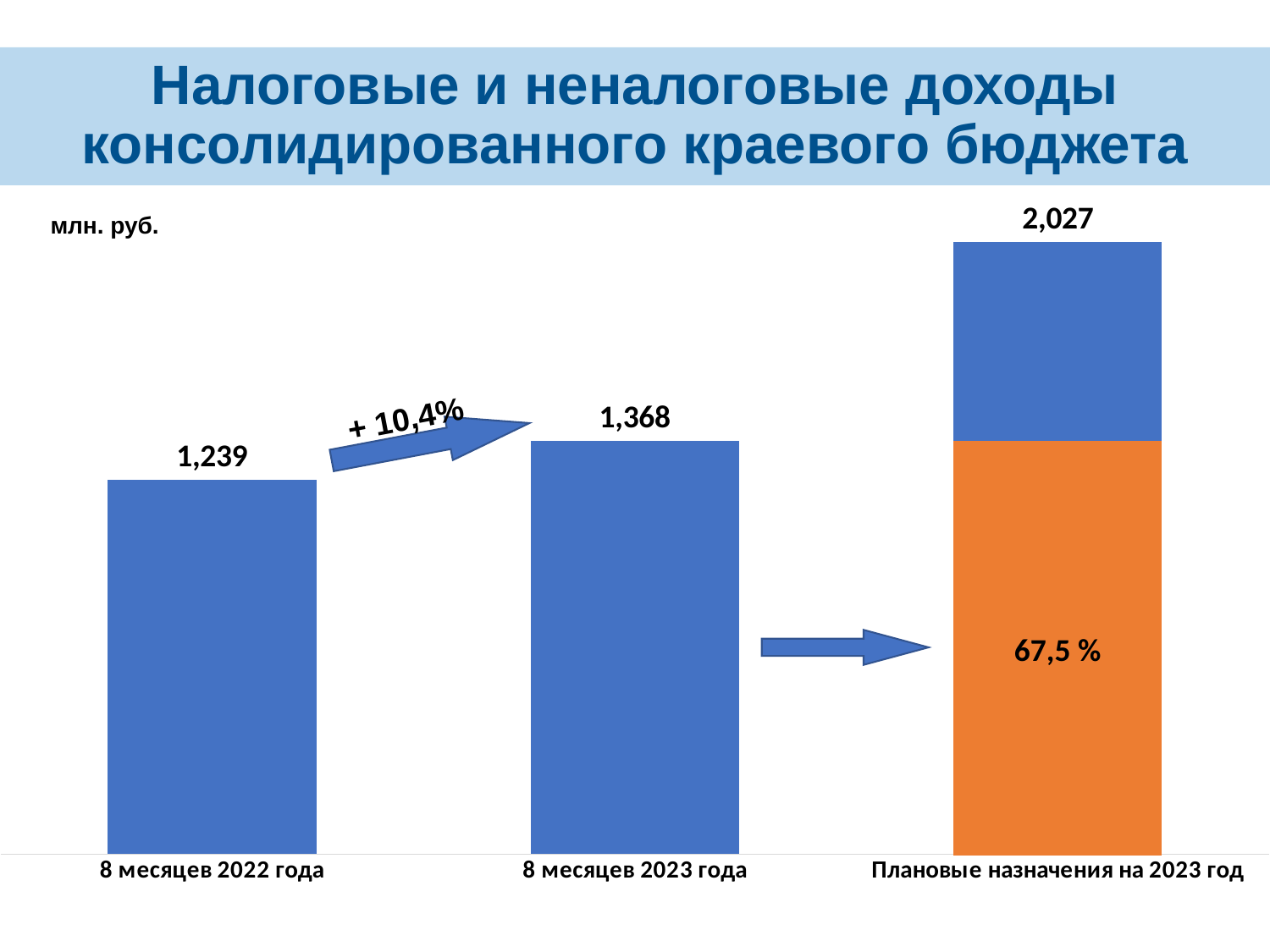
What is the value for Плановые назначения на 2023 год? 2,027 What percentage is printed on the orange segment of the Плановые назначения на 2023 год bar? 67,5 % What unit is shown in the top-left corner of the chart? млн. руб. Which category has the highest value? Плановые назначения на 2023 год What kind of chart is shown on the slide? Bar chart How many categories are shown on the x axis? 3 Which is larger, the value for 8 месяцев 2022 года or for 8 месяцев 2023 года? 8 месяцев 2023 года Which category has the lowest value? 8 месяцев 2022 года What percentage change is printed on the arrow between the 2022 and 2023 bars? + 10,4% Do the values rise or fall from left to right along the x axis? Rise What is the value for 8 месяцев 2023 года? 1,368 What is the value for 8 месяцев 2022 года? 1,239